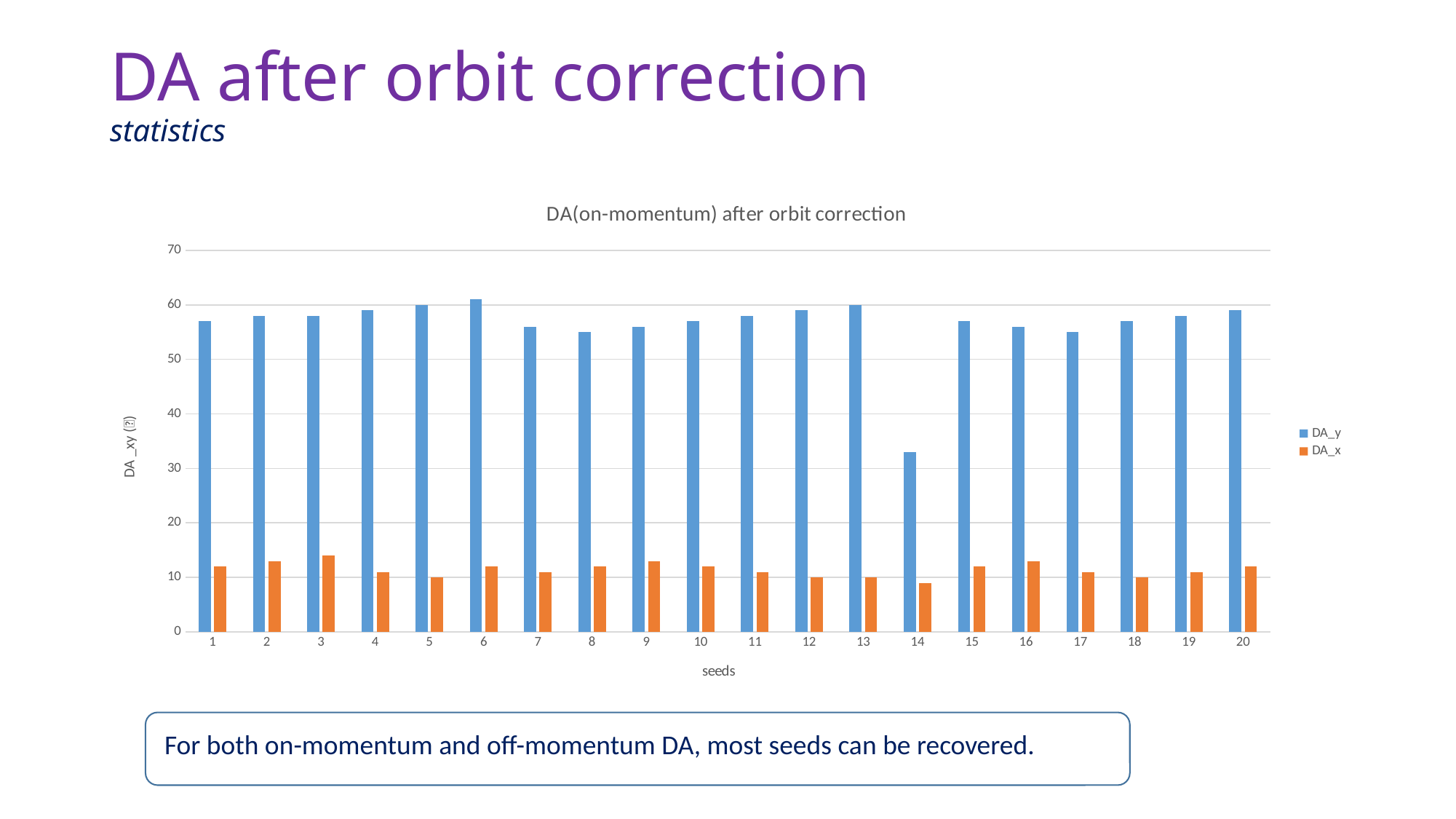
Is the DA_x value for seed 2 greater or less than 20? less What is the title of the chart? DA(on-momentum) after orbit correction Which seed has the lowest DA_y value? 14 Is the DA_y value for seed 1 greater or less than 50? greater Which is larger for seed 14: the DA_y value or the DA_x value? DA_y How many seeds are shown along the x axis? 20 Which seed has the larger DA_y value, seed 13 or seed 14? 13 Is the DA_y value for seed 14 greater or less than 40? less How many series does the legend list? 2 What kind of chart is shown on the slide? bar chart What is the label of the x axis? seeds